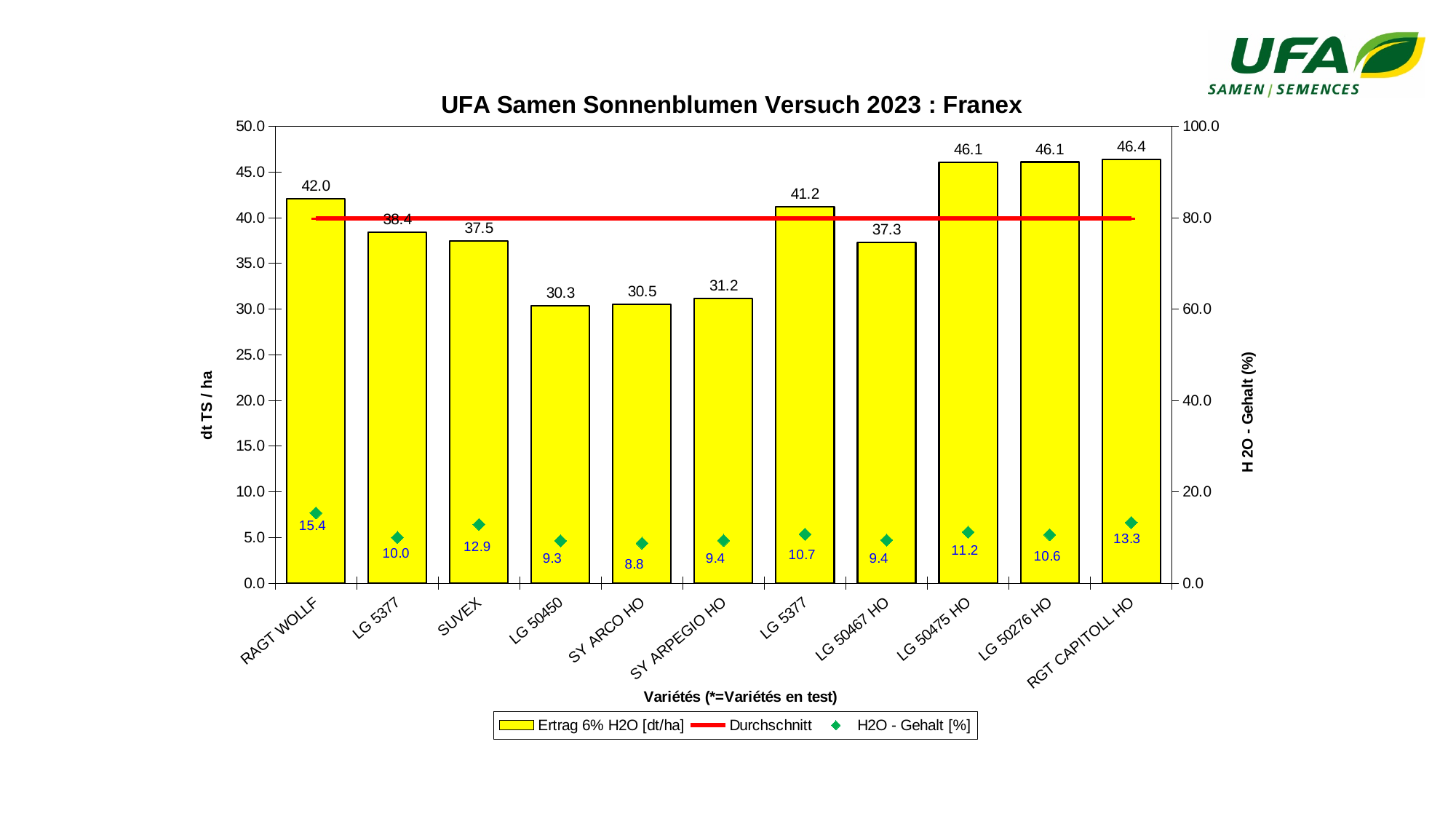
Which variety has the highest Ertrag 6% H2O [dt/ha]? RGT CAPITOLL HO What is the title of the chart? UFA Samen Sonnenblumen Versuch 2023 : Franex Is the Durchschnitt line greater or less than 35.0 dt TS / ha? greater What is the difference in Ertrag 6% H2O [dt/ha] between RGT CAPITOLL HO and SUVEX? 8.9 Which variety has the highest H2O - Gehalt [%]? RAGT WOLLF How many series does the legend list? 3 What is the Ertrag 6% H2O [dt/ha] value for RAGT WOLLF? 42.0 Which has the larger Ertrag 6% H2O [dt/ha], SY ARPEGIO HO or LG 50475 HO? LG 50475 HO Which variety has the lowest Ertrag 6% H2O [dt/ha]? LG 50450 What is the H2O - Gehalt [%] value for SY ARCO HO? 8.8 How many varieties are shown on the x axis? 11 What is the Ertrag 6% H2O [dt/ha] value for LG 50467 HO? 37.3